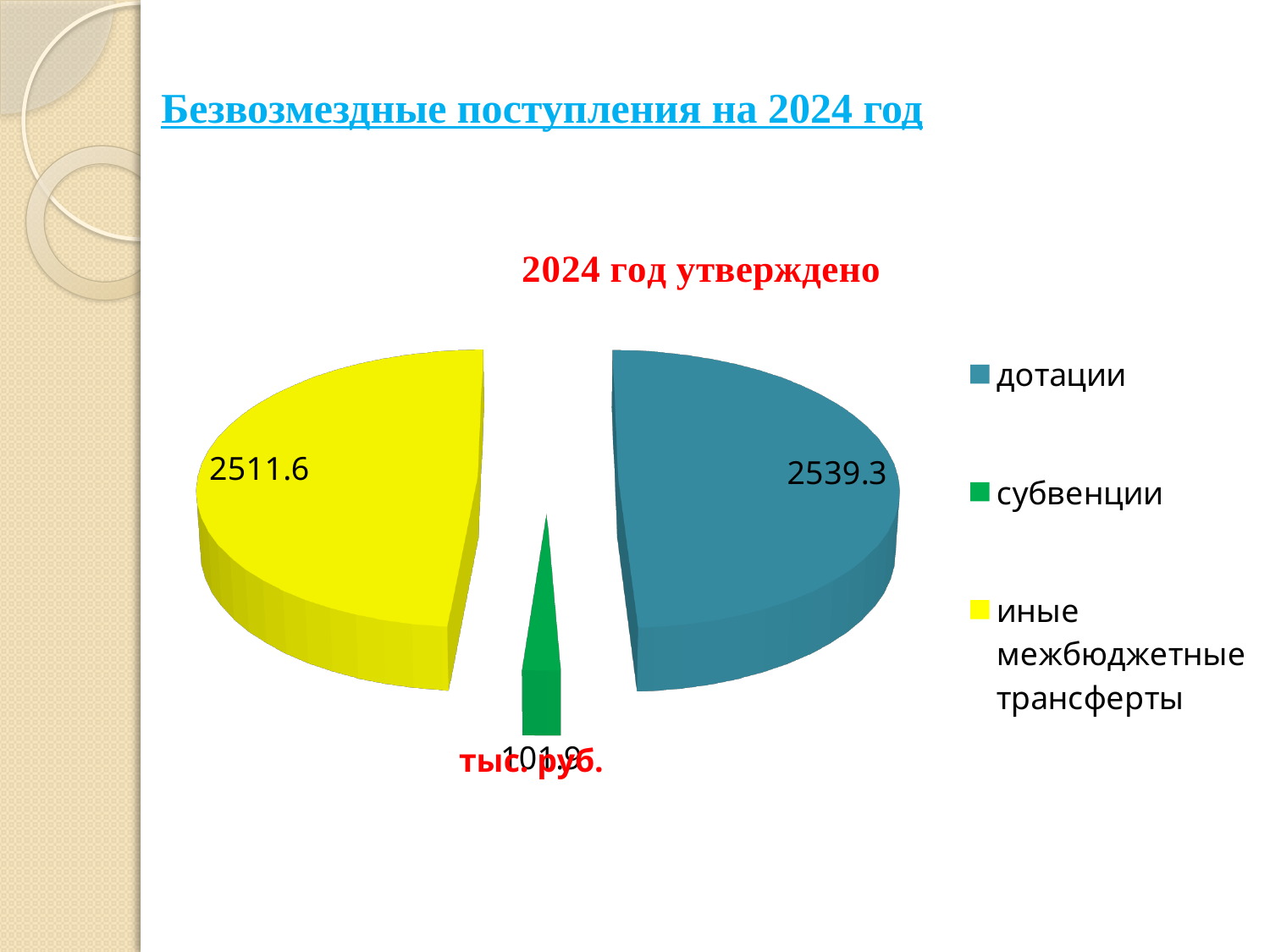
What is the difference between the values for дотации and иные межбюджетные трансферты? 27.7 What kind of chart is shown on the slide? pie chart Which is larger, the value for дотации or the value for субвенции? дотации Which category has the smallest slice in the pie chart? субвенции What colour is the slice for субвенции? green What is the title of the chart? 2024 год утверждено How many slices does the pie chart have? 3 What is the difference between the values for иные межбюджетные трансферты and субвенции? 2409.7 Which category has the largest slice in the pie chart? дотации What is the value for дотации in the pie chart? 2539.3 What is the value for субвенции in the pie chart? 101.9 What is the value for иные межбюджетные трансферты in the pie chart? 2511.6